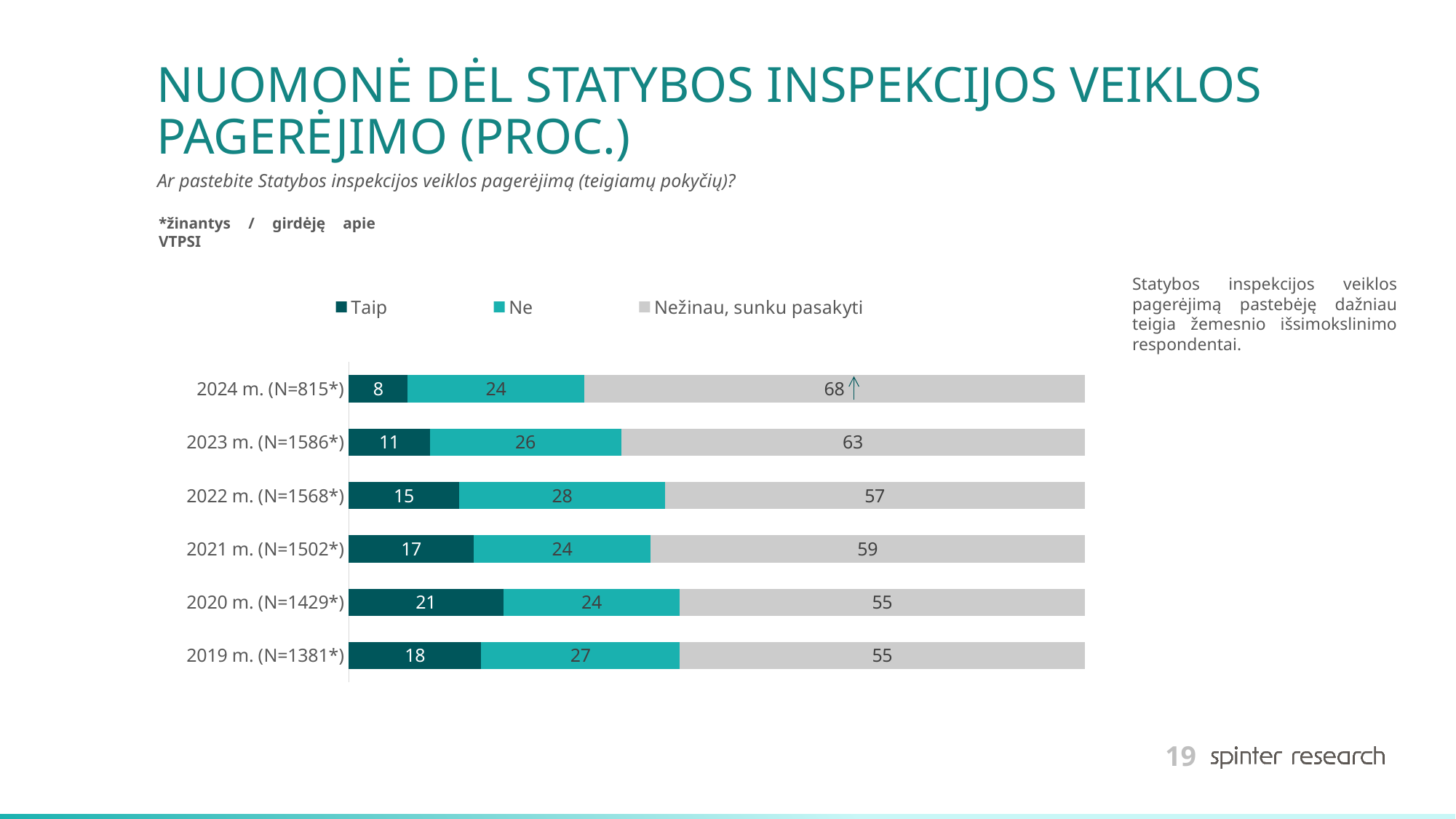
Which is larger: the "Ne" value for 2019 m. (N=1381*) or for 2021 m. (N=1502*)? 2019 m. (N=1381*) How does the "Taip" value change from 2020 m. (N=1429*) to 2024 m. (N=815*)? It falls Which year has the highest value for "Taip"? 2020 m. (N=1429*) What is the value for "Ne" in 2022 m. (N=1568*)? 28 What is the total of the stacked bar for 2021 m. (N=1502*)? 100 What is the value for "Taip" in 2024 m. (N=815*)? 8 How many series does the legend list? 3 What kind of chart is shown on the slide? Stacked bar chart What is the difference between the "Taip" values for 2020 m. (N=1429*) and 2024 m. (N=815*)? 13 Which year has the lowest value for "Nežinau, sunku pasakyti"? 2020 m. (N=1429*) and 2019 m. (N=1381*) What is the value for "Nežinau, sunku pasakyti" in 2023 m. (N=1586*)? 63 How many years (categories) are shown in the chart? 6